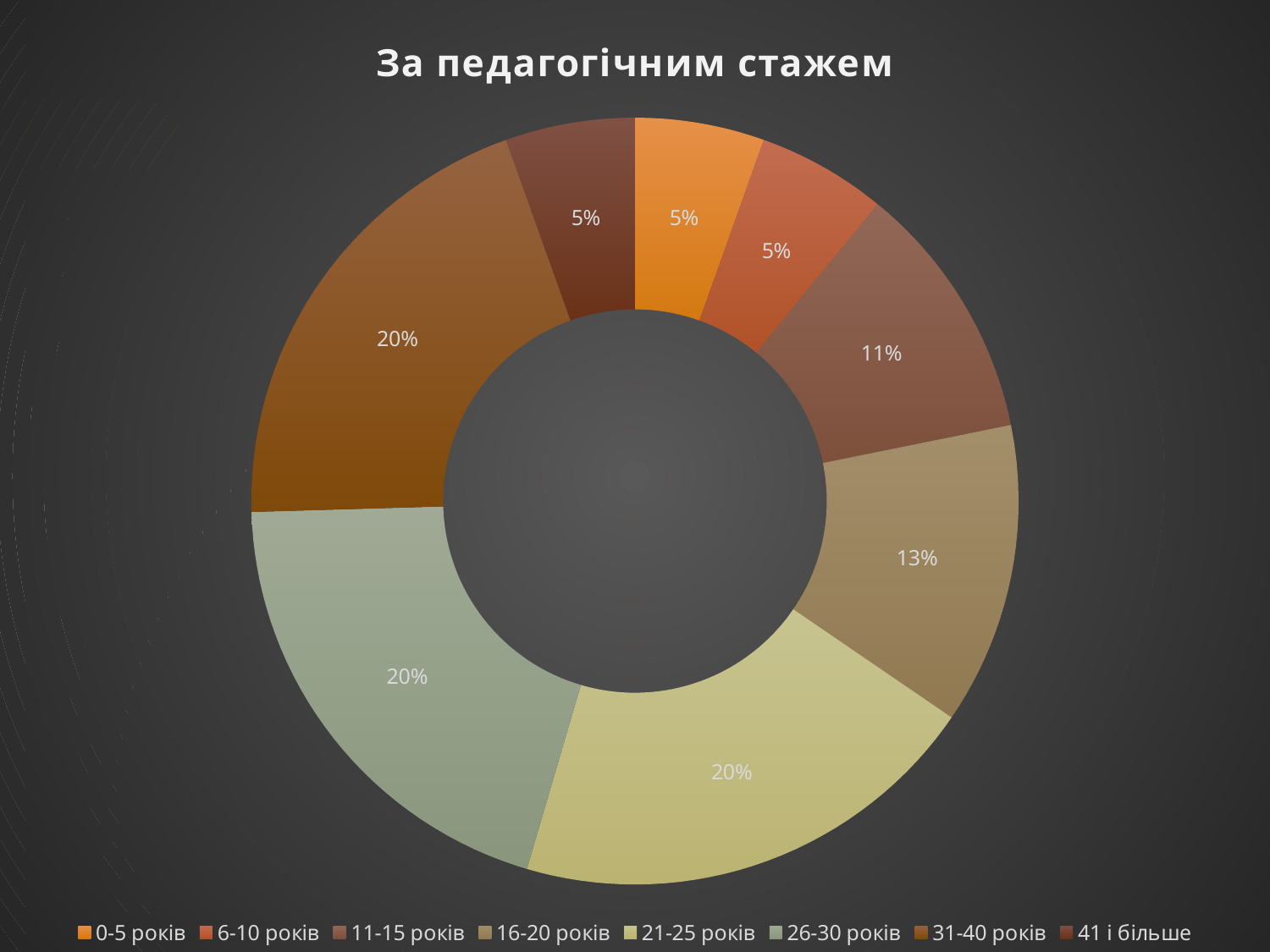
What is the difference in percentage points between the 16-20 років and 11-15 років categories? 2 What is the difference in percentage points between the 26-30 років and 0-5 років categories? 15 How many categories are shown in the chart? 8 Which is larger, the share for 16-20 років or the share for 11-15 років? 16-20 років What is the title of the chart? За педагогічним стажем What percentage is shown for the 41 і більше category? 5% What type of chart is shown on the slide? Doughnut (pie) chart What is the value for the 21-25 років category? 20% What share of the chart does the 16-20 років category represent? 13% What percentage is shown for the 11-15 років category? 11% What is the value for the 0-5 років category? 5% Which is larger, the share for 31-40 років or the share for 6-10 років? 31-40 років